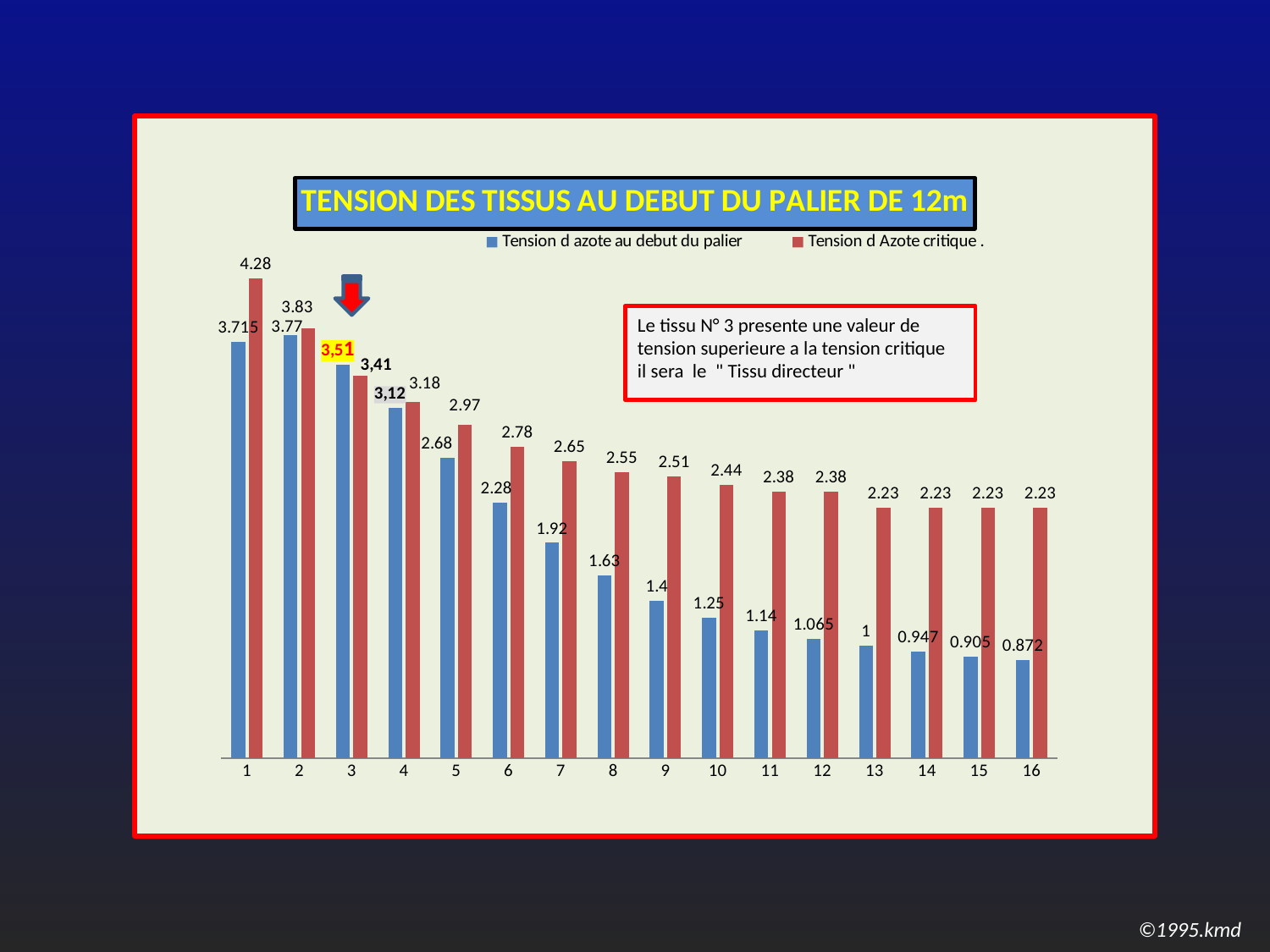
What is the difference between 'Tension d Azote critique' and 'Tension d azote au debut du palier' for tissu 8? 0.92 How many categories (tissus) are shown on the x axis? 16 Which tissu has the lowest value of 'Tension d azote au debut du palier'? 16 What is the value of 'Tension d Azote critique' for tissu 16? 2.23 Do the values of 'Tension d Azote critique' rise or fall from tissu 1 to tissu 16? fall For tissu 3, which is larger: 'Tension d azote au debut du palier' or 'Tension d Azote critique'? Tension d azote au debut du palier What is the value of 'Tension d azote au debut du palier' for tissu 1? 3.715 Which tissu has the highest value of 'Tension d Azote critique'? 1 What is the value of 'Tension d azote au debut du palier' for tissu 3? 3,51 What type of chart is shown on the slide? bar chart What is the value of 'Tension d Azote critique' for tissu 1? 4.28 How many series does the legend list? 2